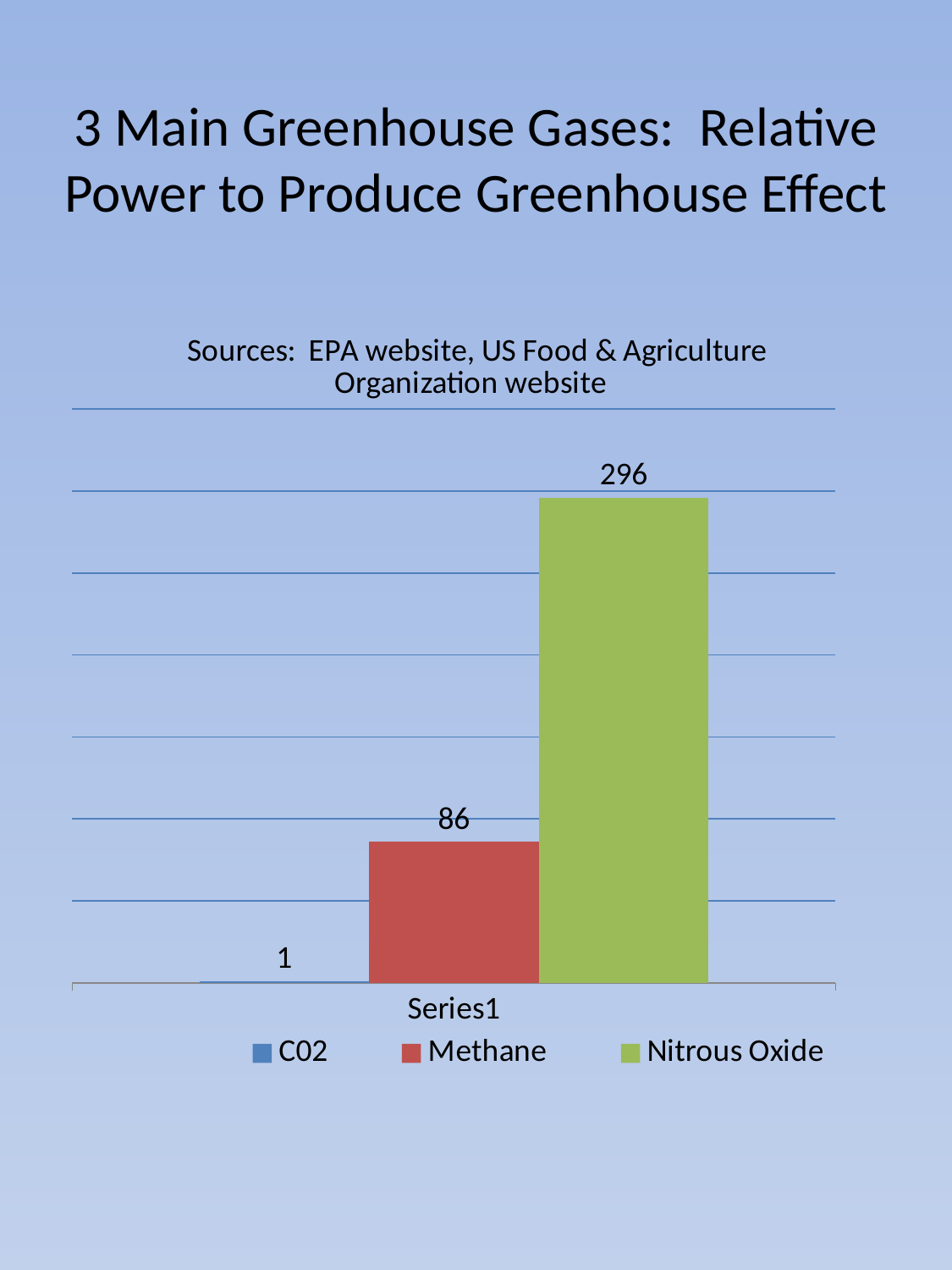
How many series does the legend list? 3 What value is shown for Methane? 86 What value is shown for C02? 1 What is the difference between the values for Nitrous Oxide and Methane? 210 Which gas has the lowest value on the chart? C02 What kind of chart is shown on the slide? Bar chart What is the category label shown on the x axis? Series1 What colour is the bar for Nitrous Oxide? Green Which has a larger value, Methane or Nitrous Oxide? Nitrous Oxide What value is shown for Nitrous Oxide? 296 Which gas has the highest value on the chart? Nitrous Oxide What is the difference between the values for Methane and C02? 85